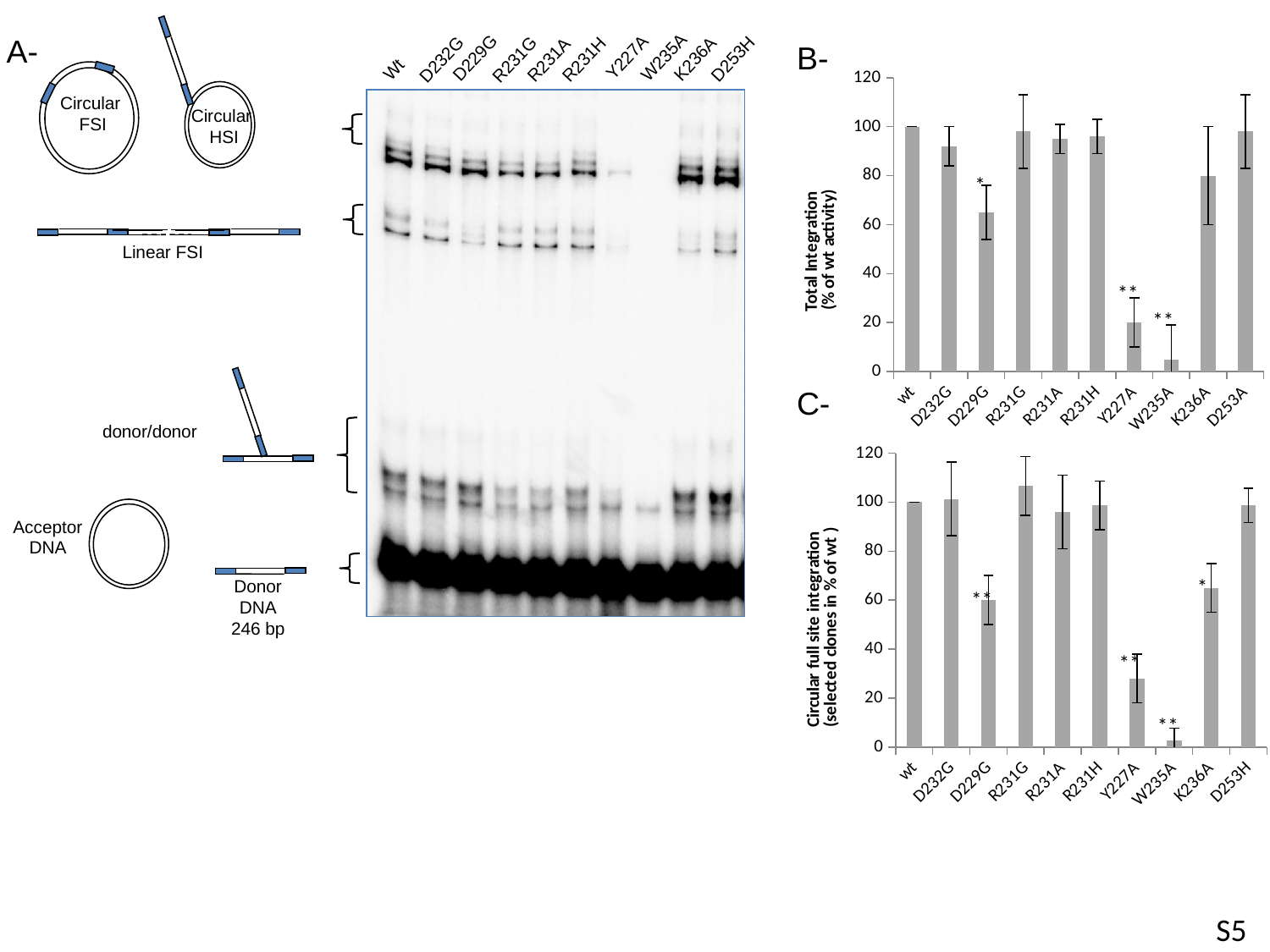
What kind of chart is chart B (Total Integration)? bar chart In chart B (Total Integration), which category has the lowest value? W235A In chart C (Circular full site integration), is the value for Y227A greater or less than 60? less In chart B (Total Integration), is the value for Y227A greater or less than 40? less How many mutant/wt categories are shown on the x axis of chart B (Total Integration)? 10 In chart C (Circular full site integration), which is larger, the value for K236A or the value for Y227A? K236A In chart C (Circular full site integration), is the value for K236A greater or less than 40? greater In chart B (Total Integration), what is the value for wt? 100 What is the y-axis title of chart B? Total Integration (% of wt activity) In chart B (Total Integration), which is larger, the value for D229G or the value for Y227A? D229G In chart C (Circular full site integration), which category has the lowest value? W235A